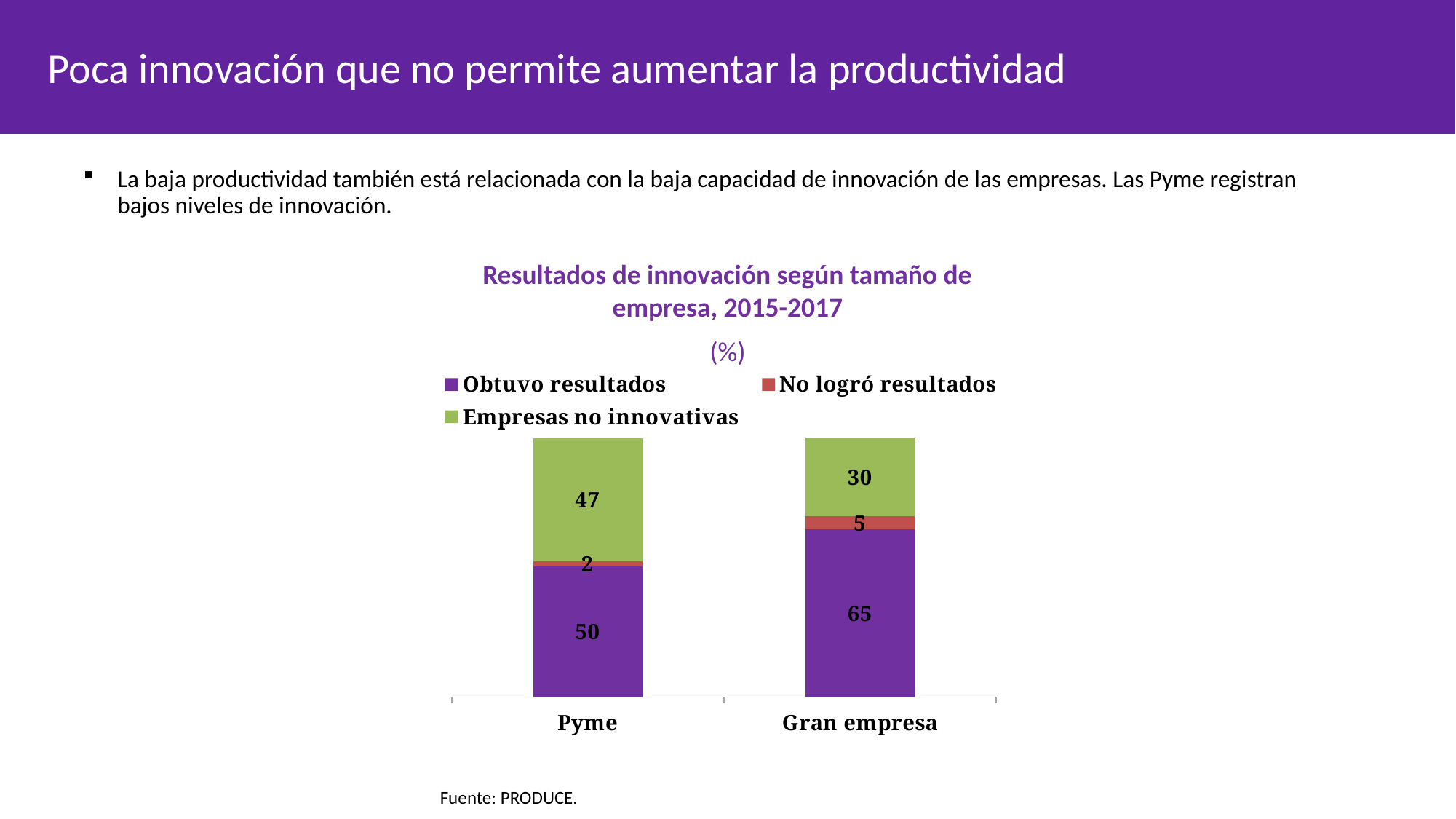
What is the value of 'Empresas no innovativas' for Gran empresa? 30 What is the value of 'Obtuvo resultados' for Pyme? 50 How many series does the legend list? 3 What is the value of 'No logró resultados' for Gran empresa? 5 What is the difference between the 'Empresas no innovativas' values for Pyme and Gran empresa? 17 Which category has the lower value for 'Empresas no innovativas'? Gran empresa Which category has the higher value for 'Obtuvo resultados', Pyme or Gran empresa? Gran empresa What type of chart is shown on the slide? Stacked bar chart What is the difference between the 'Obtuvo resultados' values for Gran empresa and Pyme? 15 What is the value of 'Empresas no innovativas' for Pyme? 47 What is the total of the stacked bar for Gran empresa? 100 What is the total of the stacked bar for Pyme? 99